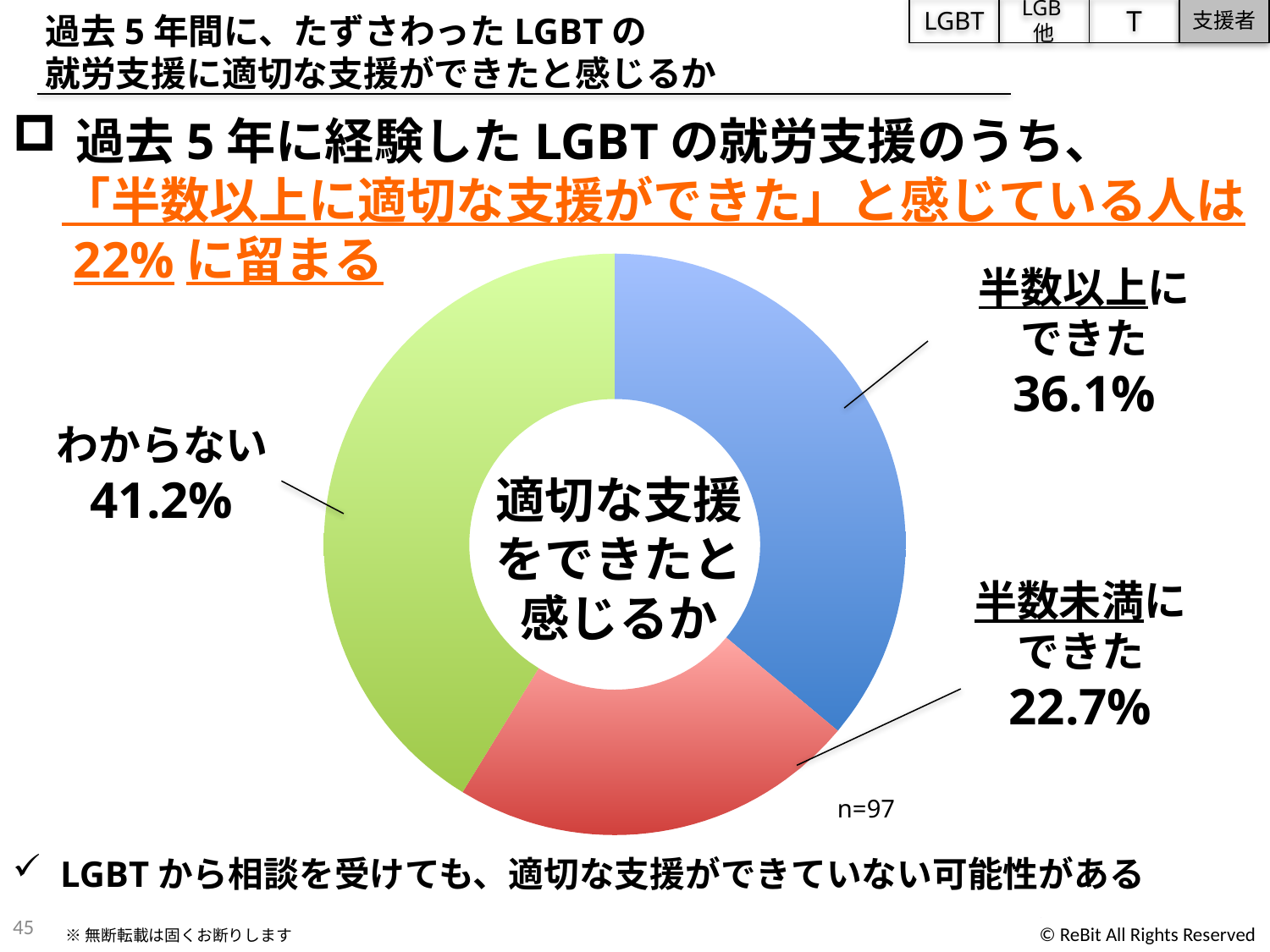
What type of chart is shown on the slide? Pie chart (donut) What percentage of respondents answered 「半数以上にできた」? 36.1% Which is larger, the share for 「半数以上にできた」 or the share for 「半数未満にできた」? 半数以上にできた Which response category has the smallest share of the chart? 半数未満にできた What is the difference in percentage points between 「わからない」 and 「半数以上にできた」? 5.1 What percentage of respondents answered 「半数未満にできた」? 22.7% What percentage of respondents answered 「わからない」? 41.2% How many response categories are shown in the chart? 3 What is the sample size (n) shown next to the chart? n=97 Which response category has the largest share of the chart? わからない What colour is the slice for 「わからない」? Green What is the difference in percentage points between 「半数以上にできた」 and 「半数未満にできた」? 13.4